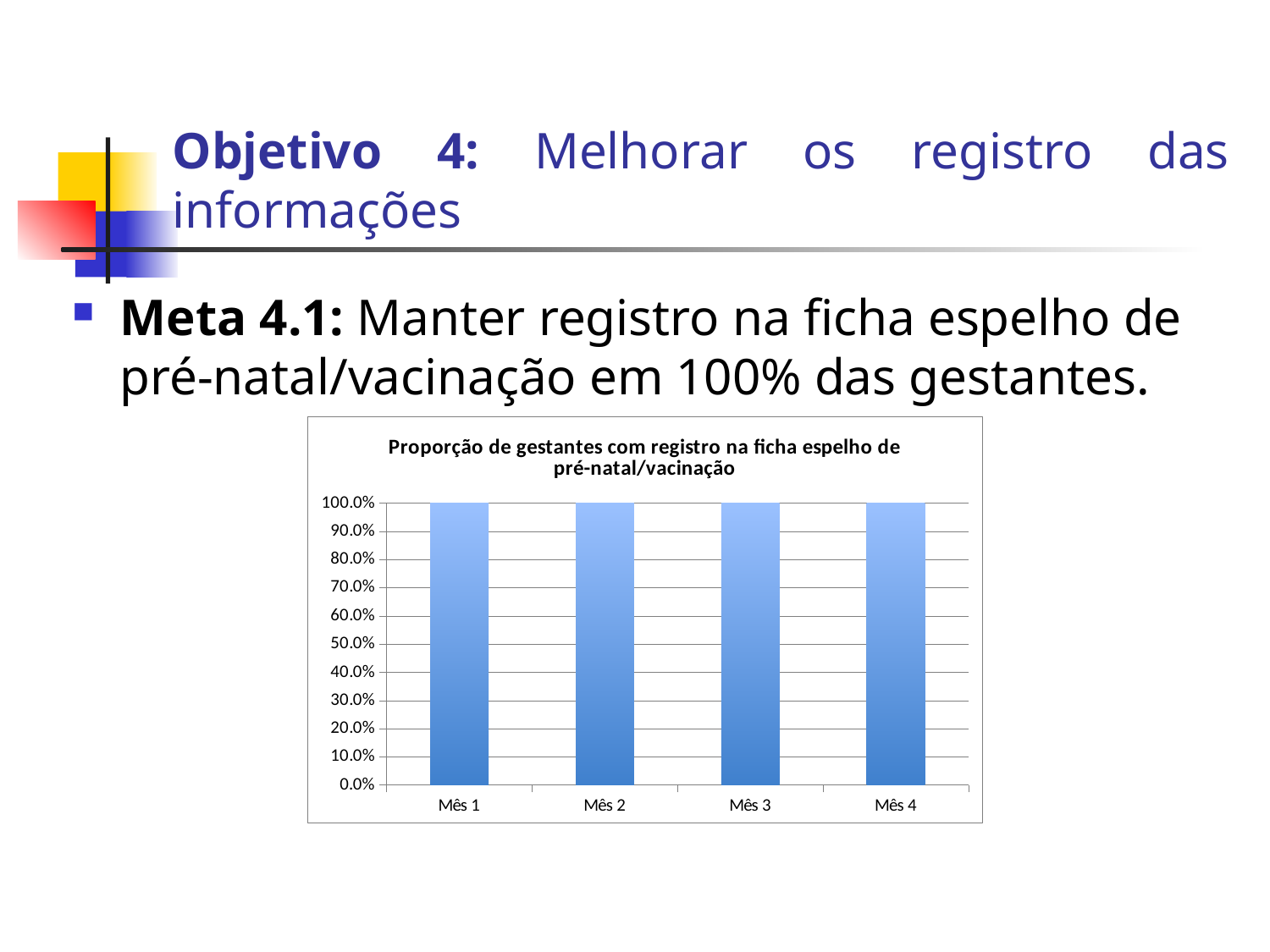
Is the value for Mês 3 greater or less than 50.0%? greater What is the value for Mês 2? 100.0% What is the value for Mês 3? 100.0% What is the highest value shown on the y axis? 100.0% What is the value for Mês 1? 100.0% Is the value for Mês 1 greater or less than 90.0%? greater What is the value for Mês 4? 100.0% What type of chart is shown on the slide? bar chart Do the values rise, fall, or stay the same from Mês 1 to Mês 4? stay the same What is the difference between the values for Mês 1 and Mês 4? 0.0% How many categories (months) are plotted on the x axis? 4 What is the title of the chart? Proporção de gestantes com registro na ficha espelho de pré-natal/vacinação